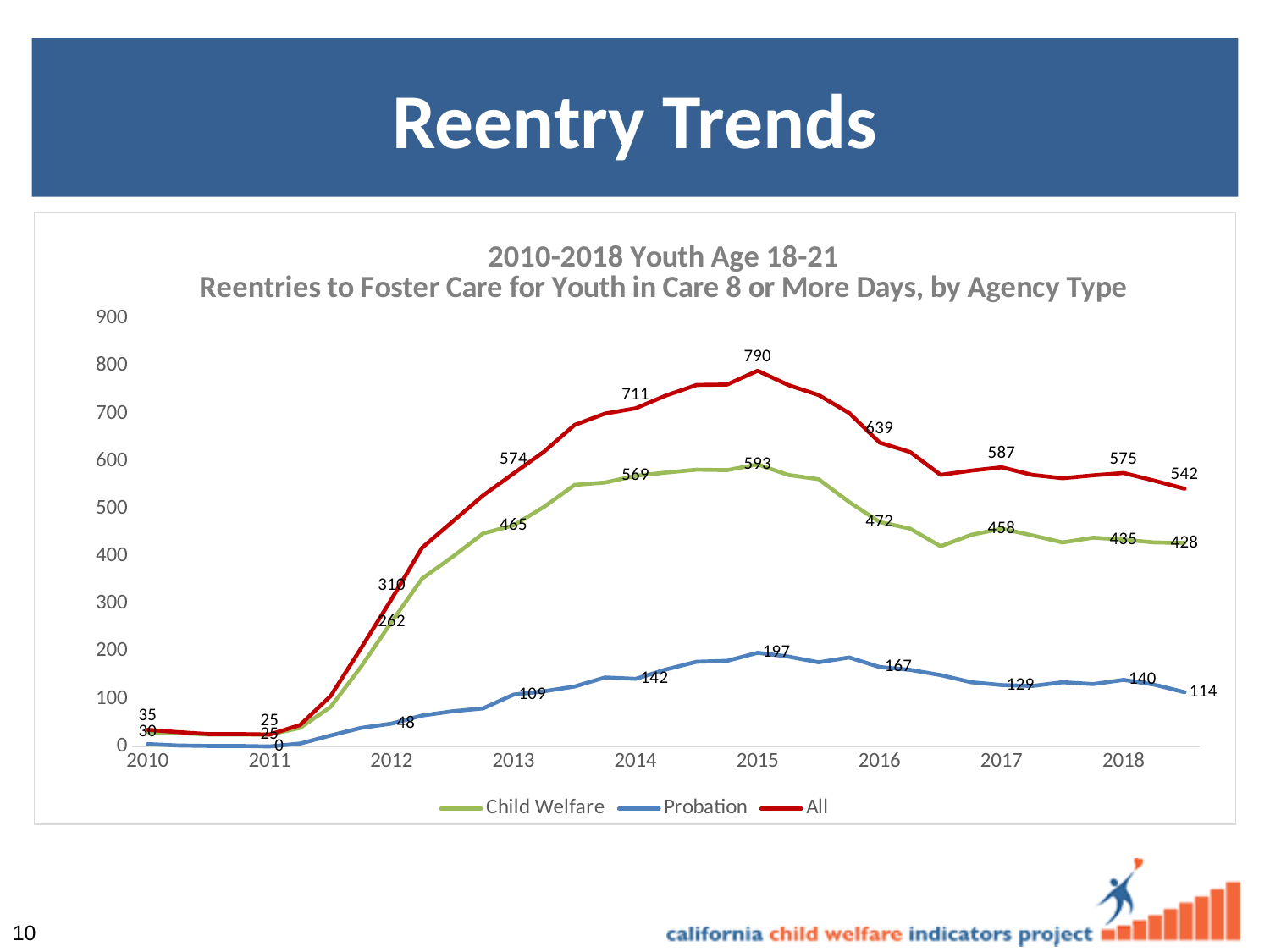
What kind of chart is shown on the slide? line chart By how much did the Probation value drop from 2015 to 2016? 30 In which year does the All series reach its highest value? 2015 What is the difference between the All value and the Child Welfare value in 2015? 197 What is the Probation value in 2012? 48 Does the All series rise or fall from 2015 to 2018? fall What is the value for the All series in 2015? 790 Which is larger, the Child Welfare value in 2014 or in 2016? 2014 What is the Child Welfare value in 2013? 465 How many series does the legend list? 3 Which series is drawn in red? All What is the Probation value in 2017? 129